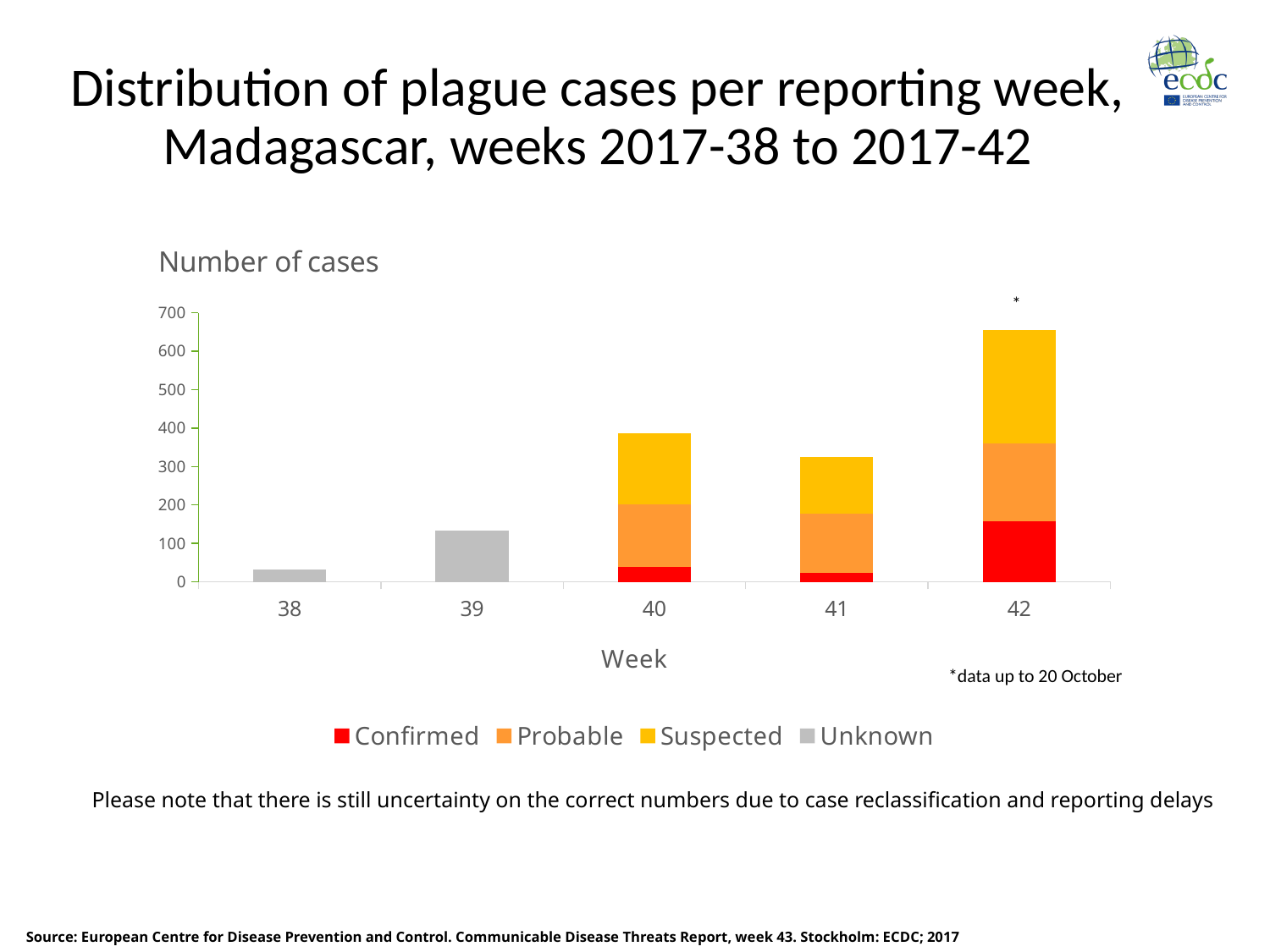
What is the label of the x axis of the chart? Week How many weeks are shown on the x axis of the chart? 5 Which week has a higher total number of cases, week 40 or week 41? 40 Is the total number of cases for week 42 greater or less than 600? greater Is the total number of cases for week 38 greater or less than 100? less Which week has the highest total number of cases? 42 What kind of chart is shown on the slide? Stacked bar chart Which series is shown in red in the chart? Confirmed Is the total number of cases for week 41 greater or less than 400? less Which week has the lowest total number of cases? 38 How many series does the chart legend list? 4